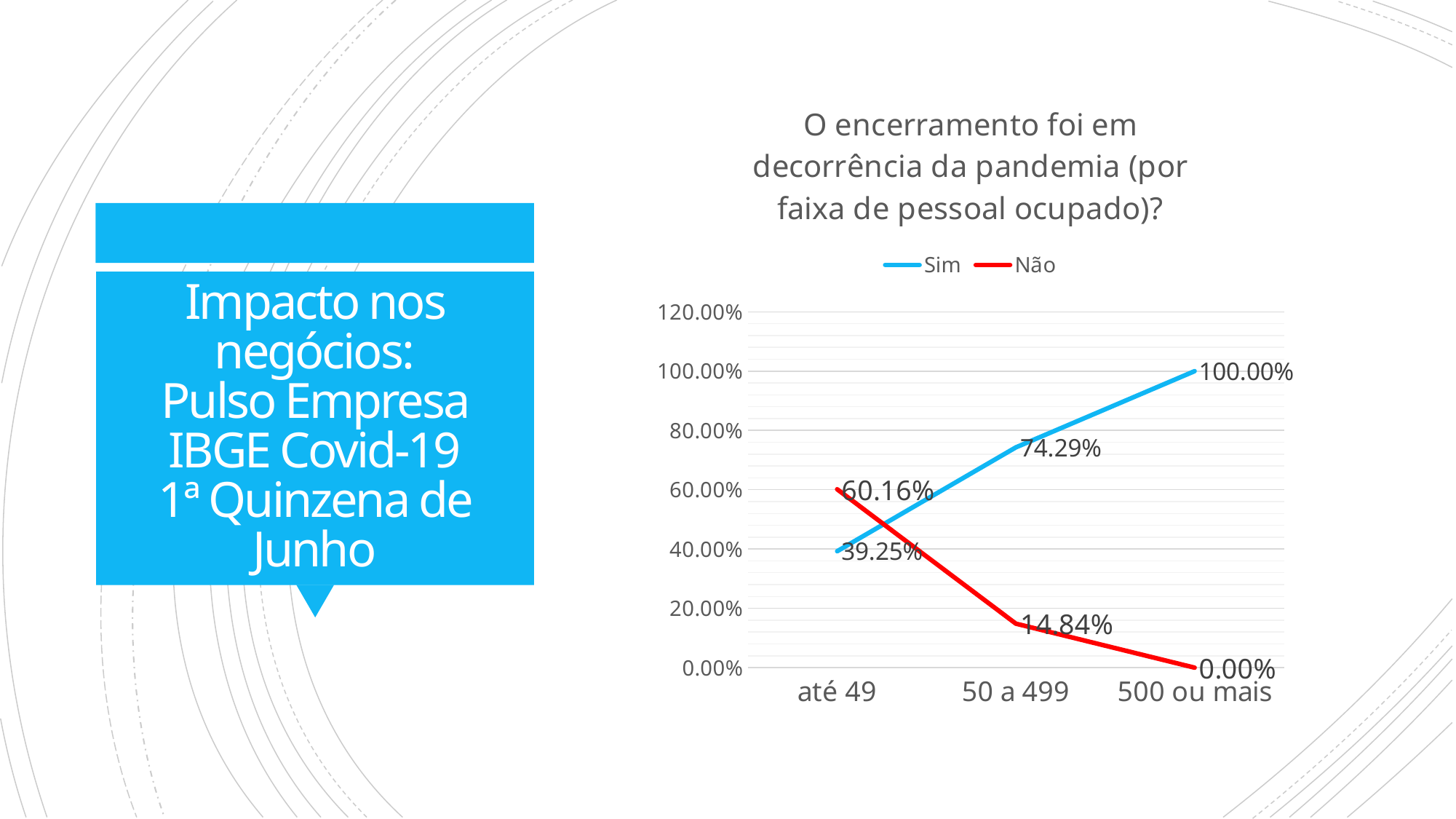
For the 'até 49' category, which series has the larger value, Sim or Não? Não How many series does the legend list? 2 Which category has the highest value for the Sim series? 500 ou mais What is the value of the Não series for the 'até 49' category? 60.16% What is the value of the Não series for the '50 a 499' category? 14.84% What is the value of the Sim series for the 'até 49' category? 39.25% How many categories are shown on the x axis? 3 What kind of chart is shown on the slide? Line chart Does the Não series rise or fall from 'até 49' to '500 ou mais'? Fall Which category has the lowest value for the Não series? 500 ou mais What is the value of the Sim series for the '500 ou mais' category? 100.00% What is the difference between the Sim and Não values for the '50 a 499' category? 59.45%